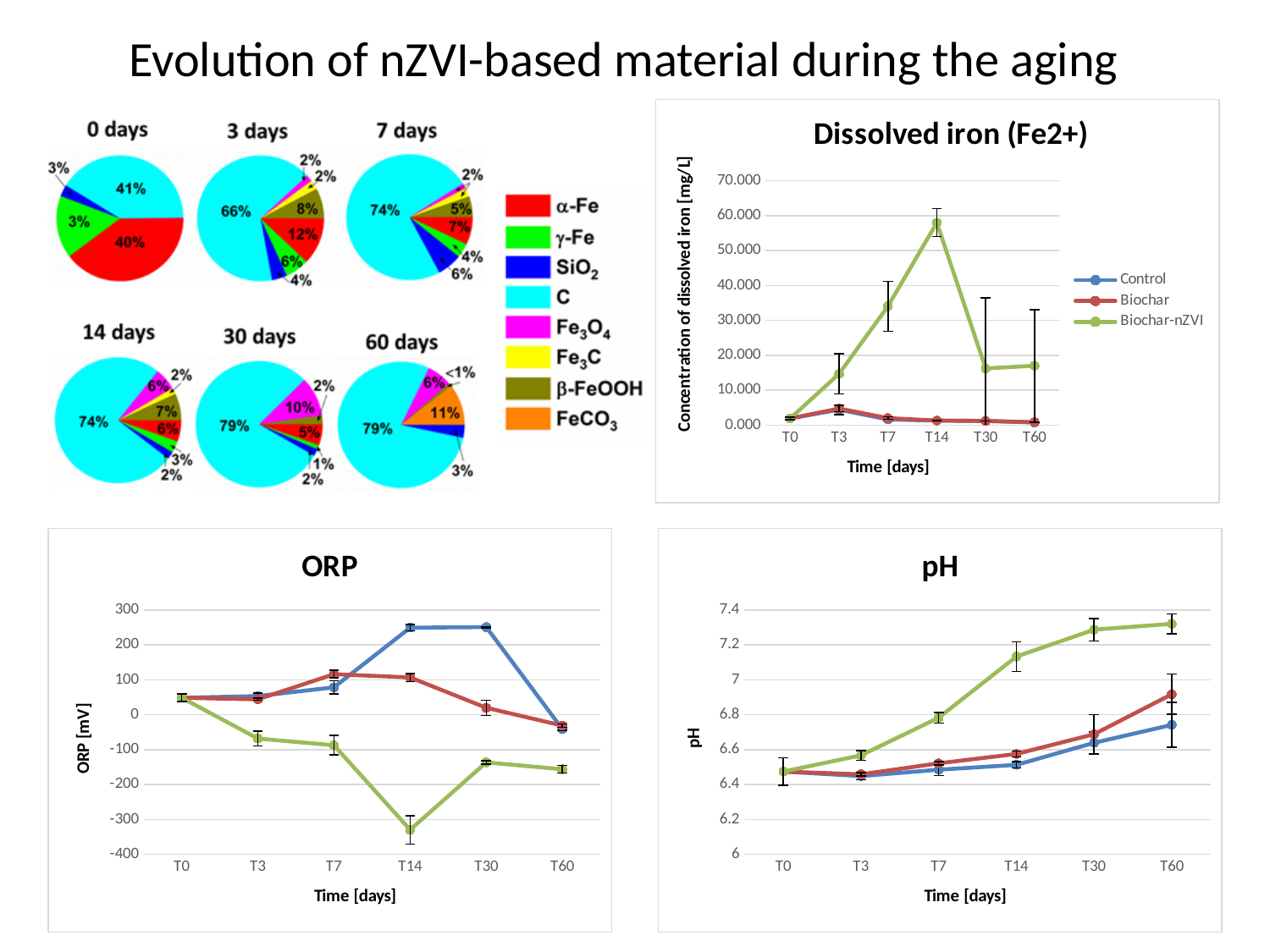
How much larger is the C share in the 60 days pie chart than in the 0 days pie chart? 38% In the 3 days pie chart, what share does α-Fe have? 12% In the Dissolved iron (Fe2+) chart, at which time point does Biochar-nZVI reach its highest value? T14 In the 0 days pie chart, what share does C have? 41% In the ORP chart, at which time point is the Biochar-nZVI value lowest? T14 How many time points are plotted on the x axis of the pH chart? 6 In the ORP chart, is the Biochar-nZVI value at T14 greater or less than -300? less In the Dissolved iron (Fe2+) chart, is the Biochar-nZVI value at T14 greater or less than 50.000? greater In the pH chart, which series has the highest value at T60? Biochar-nZVI In the 60 days pie chart, what share does C have? 79% How many series does the legend of the Dissolved iron (Fe2+) chart list? 3